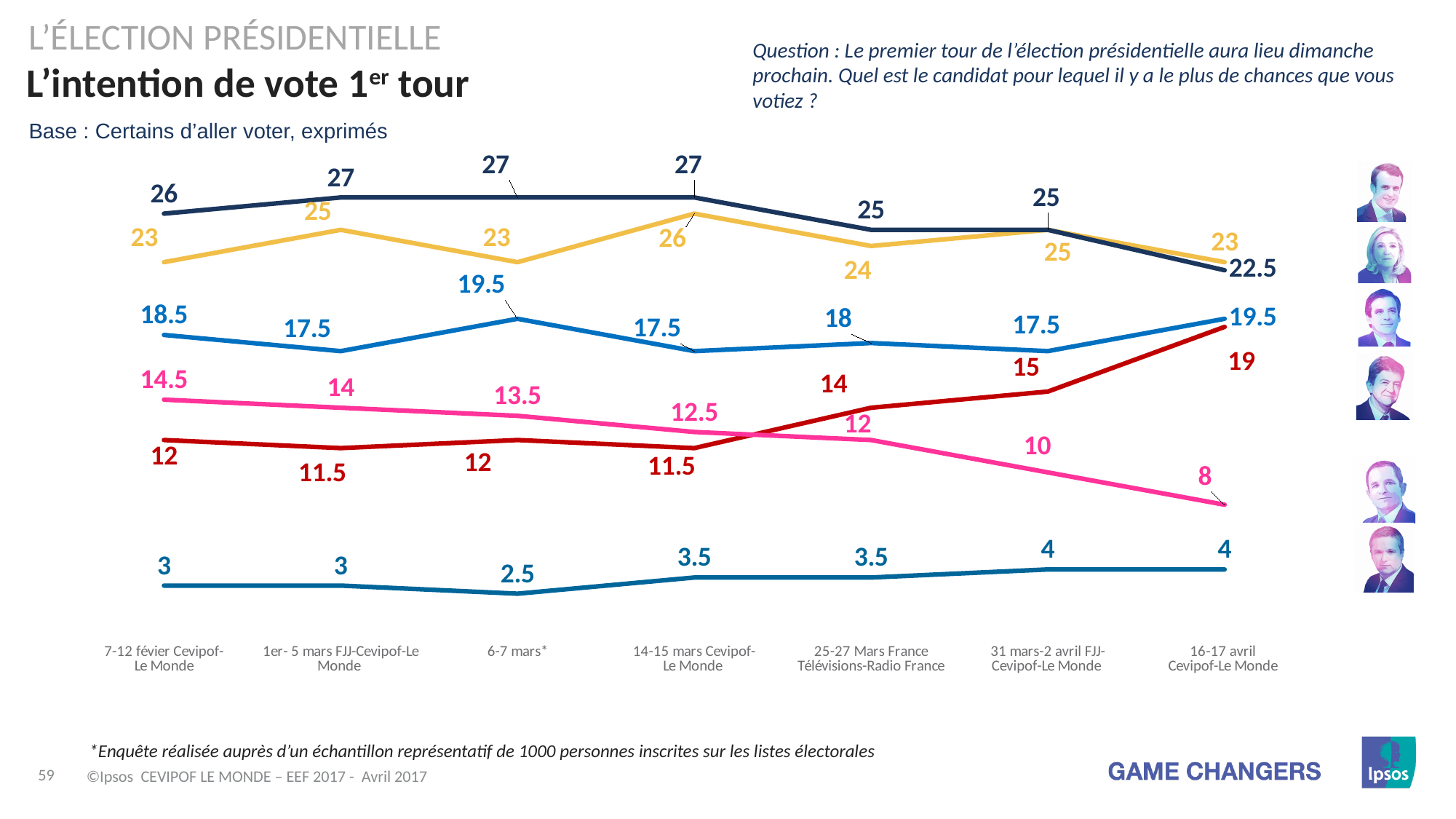
At which survey date is the pink line at its lowest value? 16-17 avril Cevipof-Le Monde How many survey dates (points along the x axis) are plotted on the chart? 7 What is the value of the red line at the 16-17 avril Cevipof-Le Monde survey? 19 At the 25-27 Mars France Télévisions-Radio France survey, which is larger: the red line or the pink line? the red line What is the value of the pink line at the 6-7 mars survey? 13.5 What is the value of the dark navy line at the 16-17 avril Cevipof-Le Monde survey? 22.5 Does the pink line rise or fall from the first survey to the last survey? fall What kind of chart is shown on the slide? line chart What is the value of the yellow line at the 14-15 mars Cevipof-Le Monde survey? 26 What is the difference between the dark navy line and the yellow line at the 7-12 février Cevipof-Le Monde survey? 3 How many lines are plotted on the chart? 6 Does the red line rise or fall between the 14-15 mars survey and the 16-17 avril survey? rise